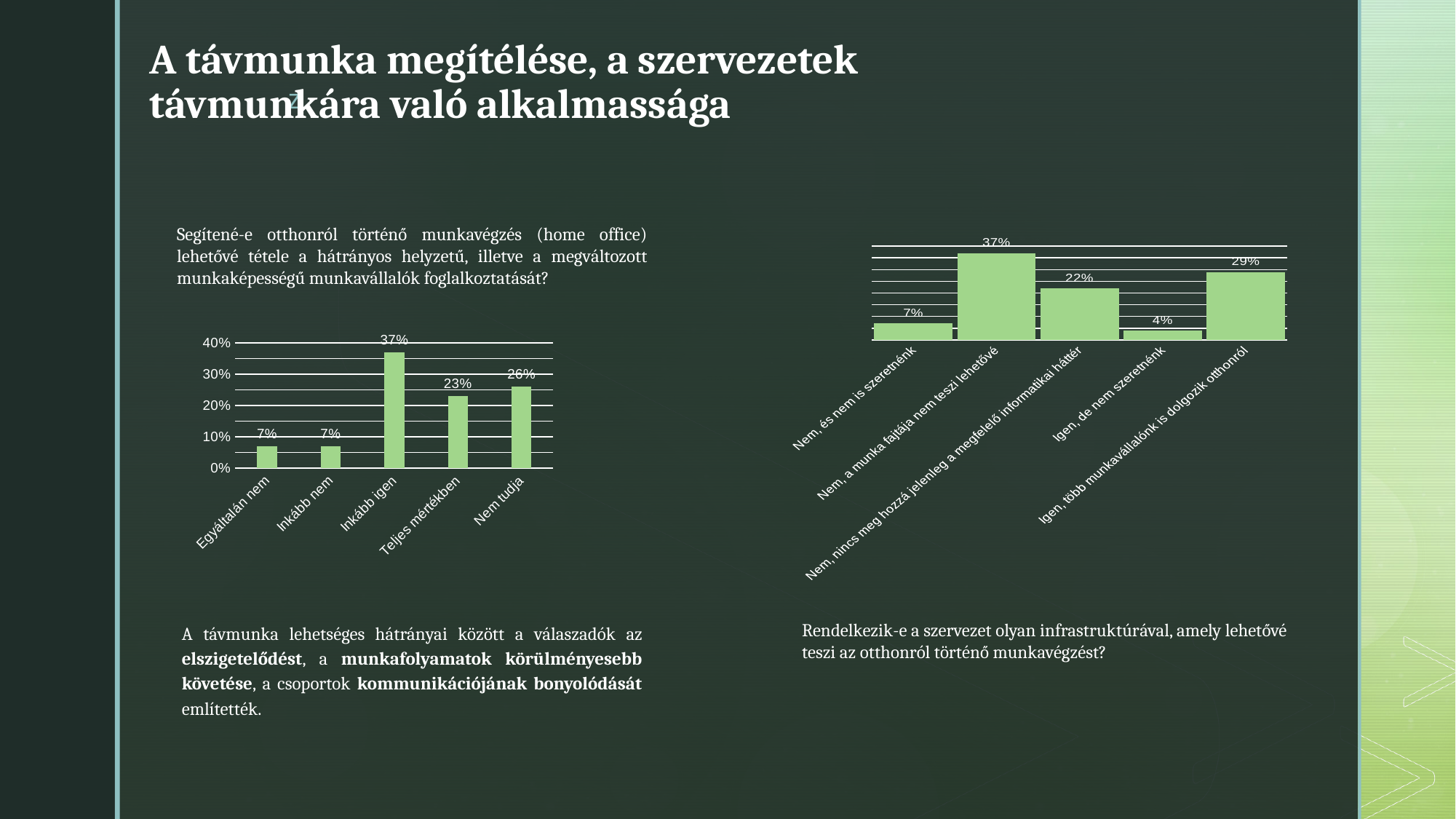
In the left chart, what is the value for 'Teljes mértékben'? 23% In the right chart, which is larger: 'Nem, a munka fajtája nem teszi lehetővé' or 'Nem, nincs meg hozzá jelenleg a megfelelő informatikai háttér'? Nem, a munka fajtája nem teszi lehetővé In the right chart, which category has the lowest value? Igen, de nem szeretnénk In the left chart, what is the difference between 'Nem tudja' and 'Teljes mértékben'? 3% In the left chart, what is the value for 'Inkább igen'? 37% In the right chart, what is the value for 'Igen, több munkavállalónk is dolgozik otthonról'? 29% In the left chart, is the value for 'Nem tudja' greater or less than 20%? greater In the left chart, which category has the highest value? Inkább igen In the right chart, what is the difference between 'Nem, a munka fajtája nem teszi lehetővé' and 'Nem, és nem is szeretnénk'? 30% In the left chart, how many categories are shown? 5 In the right chart, what is the value for 'Igen, de nem szeretnénk'? 4% What type of chart is the right chart? Bar chart